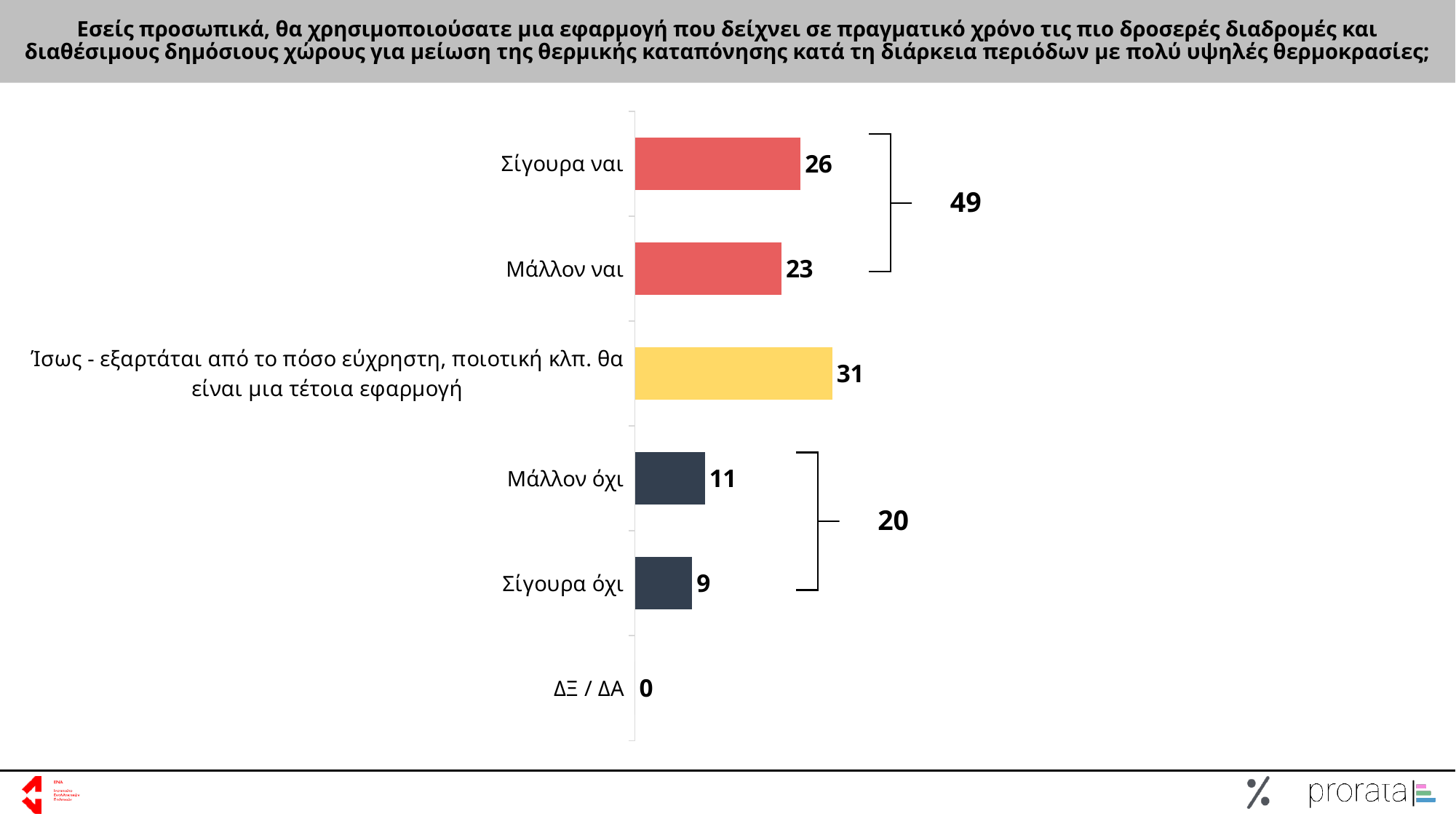
What is the value for "Σίγουρα όχι"? 9 What is the value for "Σίγουρα ναι"? 26 How many categories are shown in the chart? 6 Which is larger, the value for "Μάλλον ναι" or the value for "Σίγουρα όχι"? Μάλλον ναι What is the difference between the values for "Σίγουρα ναι" and "Μάλλον όχι"? 15 Which category has the highest value? Ίσως - εξαρτάται από το πόσο εύχρηστη, ποιοτική κλπ. θα είναι μια τέτοια εφαρμογή Which category has the lowest value? ΔΞ / ΔΑ What kind of chart is shown on the slide? Bar chart What is the value for "Ίσως - εξαρτάται από το πόσο εύχρηστη, ποιοτική κλπ. θα είναι μια τέτοια εφαρμογή"? 31 What combined value is shown by the bracket grouping "Μάλλον όχι" and "Σίγουρα όχι"? 20 What is the value for "Μάλλον ναι"? 23 What is the value for "ΔΞ / ΔΑ"? 0